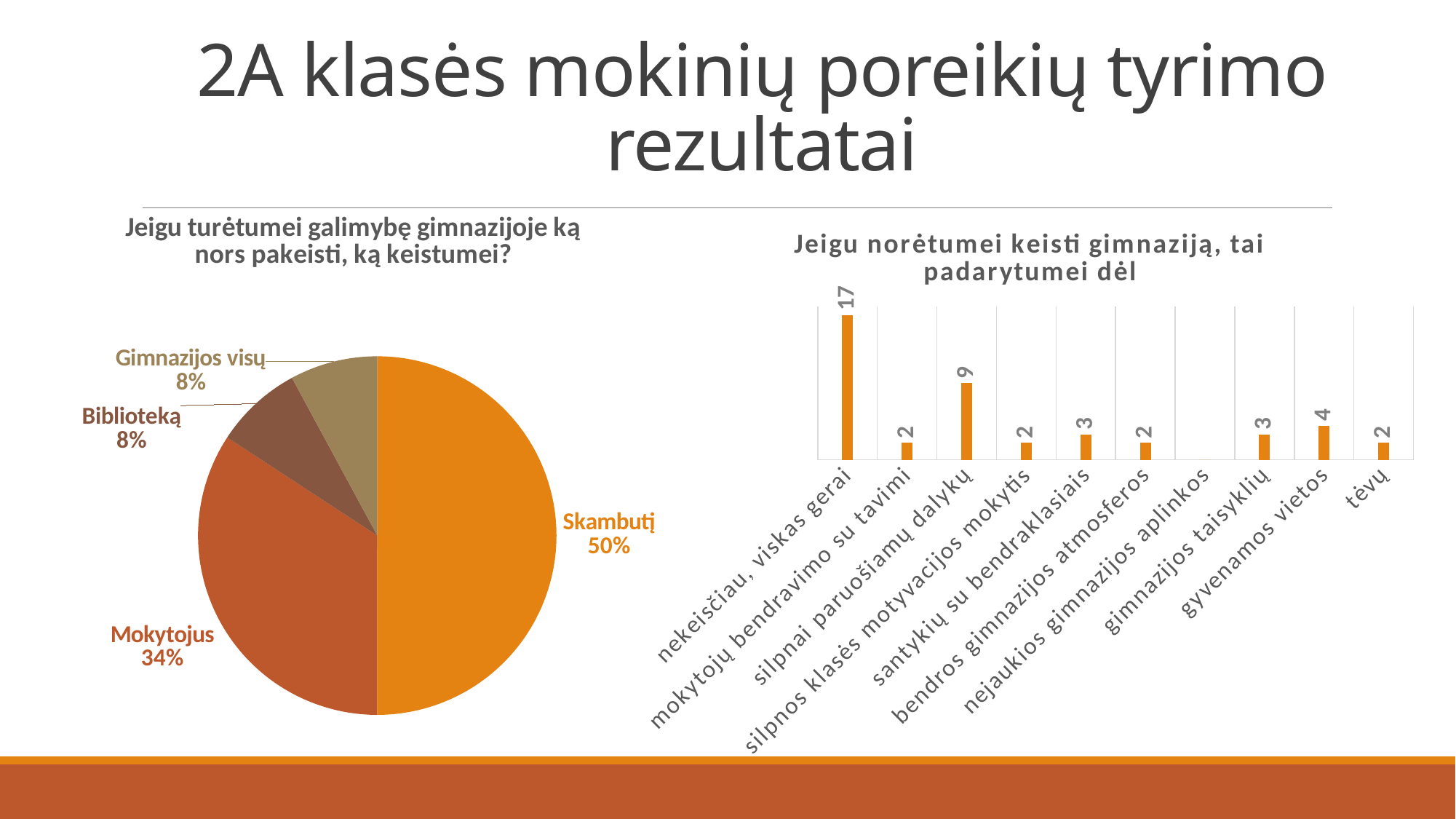
In the pie chart on the left, which category has the largest share? Skambutį In the bar chart on the right, what is the value for 'gyvenamos vietos'? 4 What type of chart is the chart on the right of the slide? Bar chart In the bar chart on the right, what is the value for 'silpnai paruošiamų dalykų'? 9 In the bar chart on the right, what is the value for 'nekeisčiau, viskas gerai'? 17 In the bar chart on the right, which is larger: 'santykių su bendraklasiais' or 'gyvenamos vietos'? gyvenamos vietos In the pie chart on the left, what share of responses is 'Mokytojus'? 34% In the pie chart on the left, what share of responses is 'Skambutį'? 50% In the bar chart on the right, what is the difference between 'nekeisčiau, viskas gerai' and 'silpnai paruošiamų dalykų'? 8 In the pie chart on the left, what is the difference in percentage points between 'Skambutį' and 'Mokytojus'? 16 In the pie chart on the left, how many slices are there? 4 In the bar chart on the right, which category has the highest value? nekeisčiau, viskas gerai